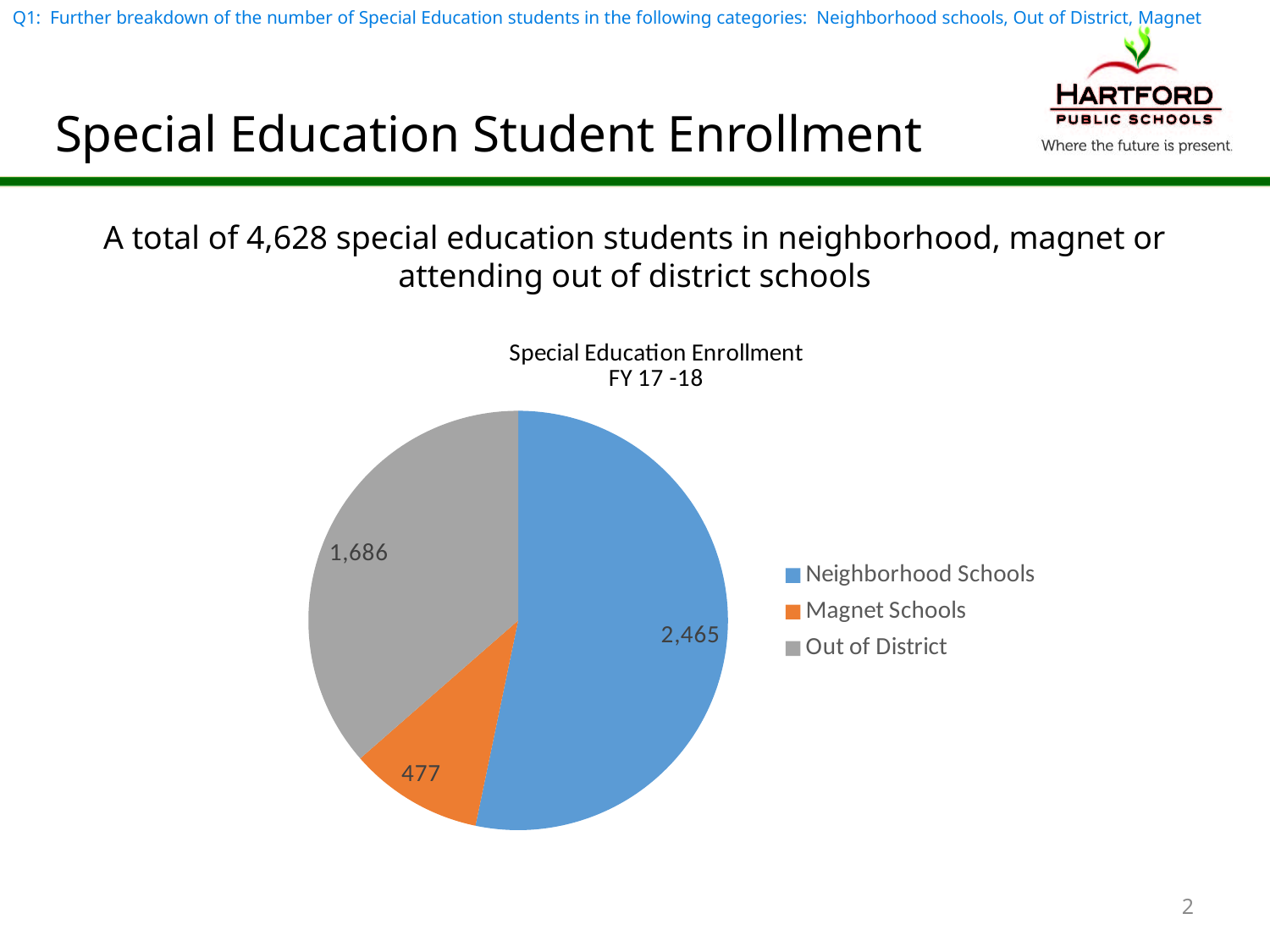
What is the value for Out of District in the pie chart? 1,686 What is the value for Magnet Schools in the pie chart? 477 What is the title of the chart? Special Education Enrollment FY 17 -18 How many categories are shown in the pie chart? 3 What is the total of all three slices in the pie chart? 4,628 Which is larger, the value for Out of District or the value for Magnet Schools? Out of District Which category has the smallest slice of the pie chart? Magnet Schools Which category has the largest slice of the pie chart? Neighborhood Schools What is the difference between the Out of District value and the Magnet Schools value? 1,209 What is the value for Neighborhood Schools in the pie chart? 2,465 What kind of chart is shown on the slide? Pie chart What is the difference between the Neighborhood Schools value and the Out of District value? 779